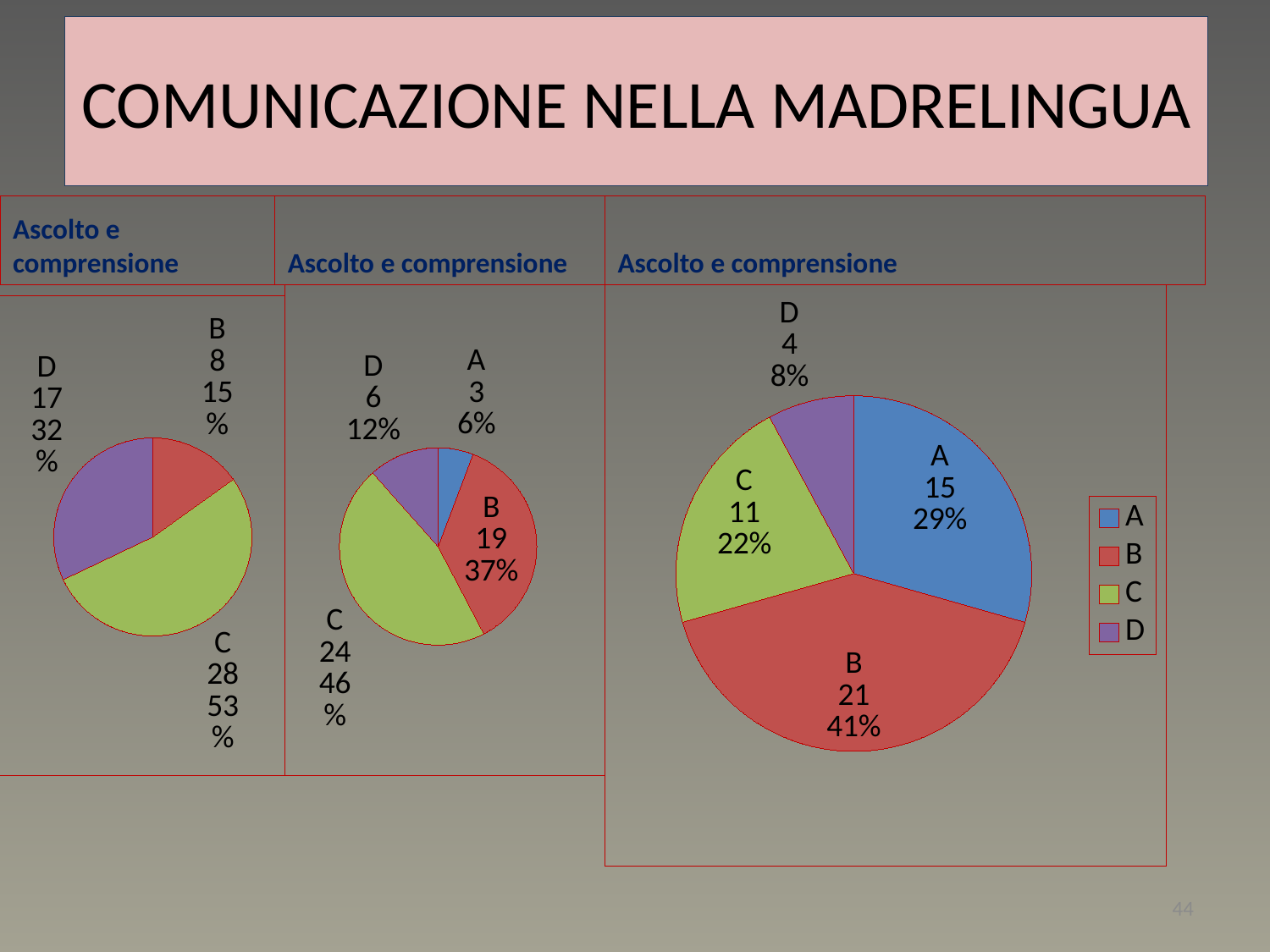
How many entries does the legend of the right pie chart list? 4 In the middle pie chart, which category has the largest slice? C What type of chart is used on this slide? pie chart In the right pie chart, what is the value for A? 15 In the middle pie chart, what is the value for B? 19 In the middle pie chart, what is the difference between the values for C and D? 18 In the right pie chart, what share of the pie does D represent? 8% In the middle pie chart, what share of the pie does A represent? 6% In the left pie chart, what is the value for C? 28 In the left pie chart, which category has the smallest slice? B In the right pie chart, which is larger, the value for B or the value for C? B In the left pie chart, what share of the pie does D represent? 32%